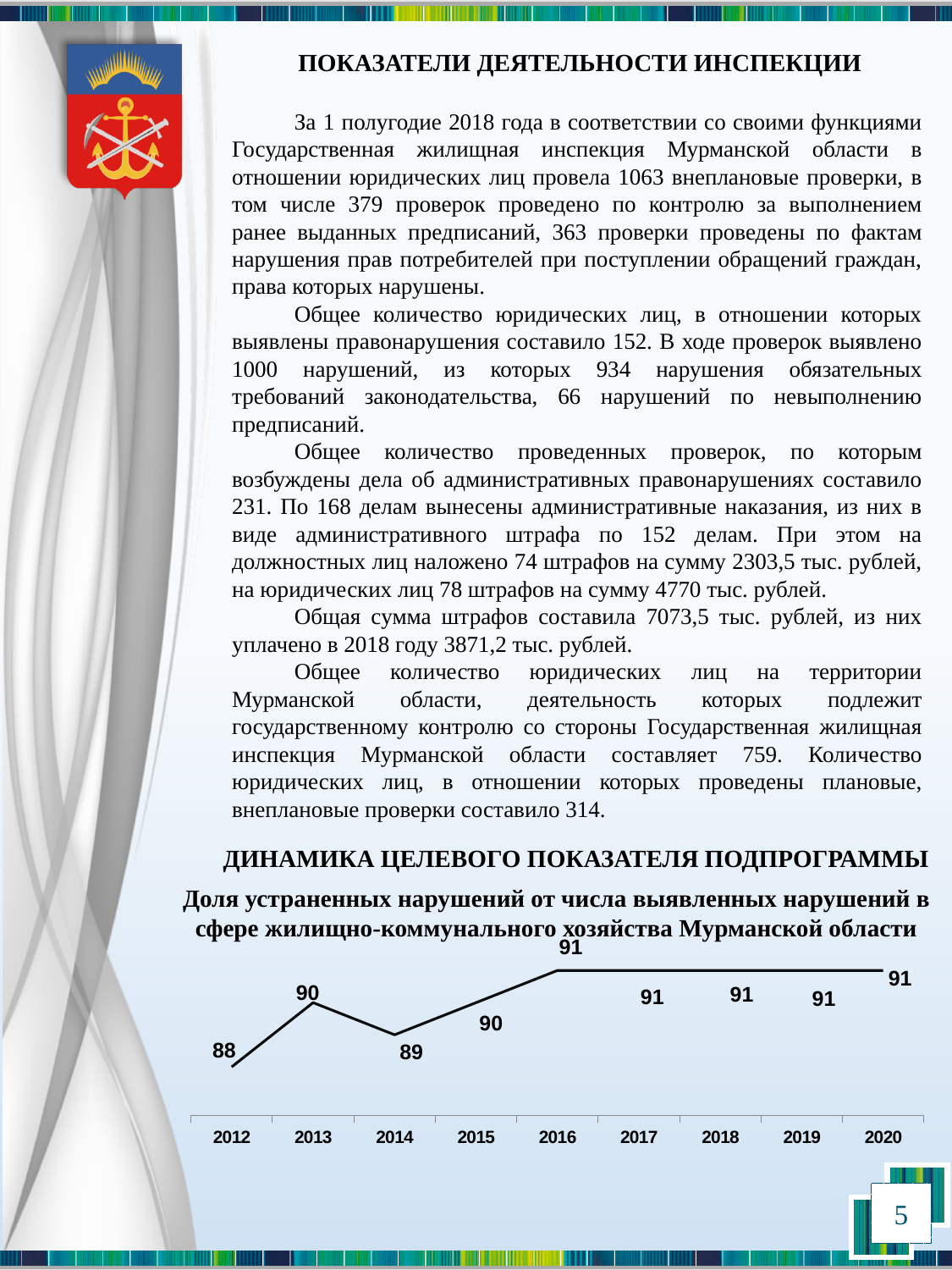
Which year has the larger value, 2013 or 2014? 2013 What is the value for 2014 in the chart? 89 What is the difference between the values for 2016 and 2012? 3 What is the value for 2013 in the chart? 90 What type of chart is shown on the slide? Line chart What is the value for 2016 in the chart? 91 How many years are plotted on the x axis of the chart? 9 Which year has the lowest value in the chart? 2012 What is the highest value shown in the chart? 91 What is the value for 2012 in the chart? 88 What is the first year shown on the x axis of the chart? 2012 Do the values generally rise or fall from 2012 to 2020? Rise